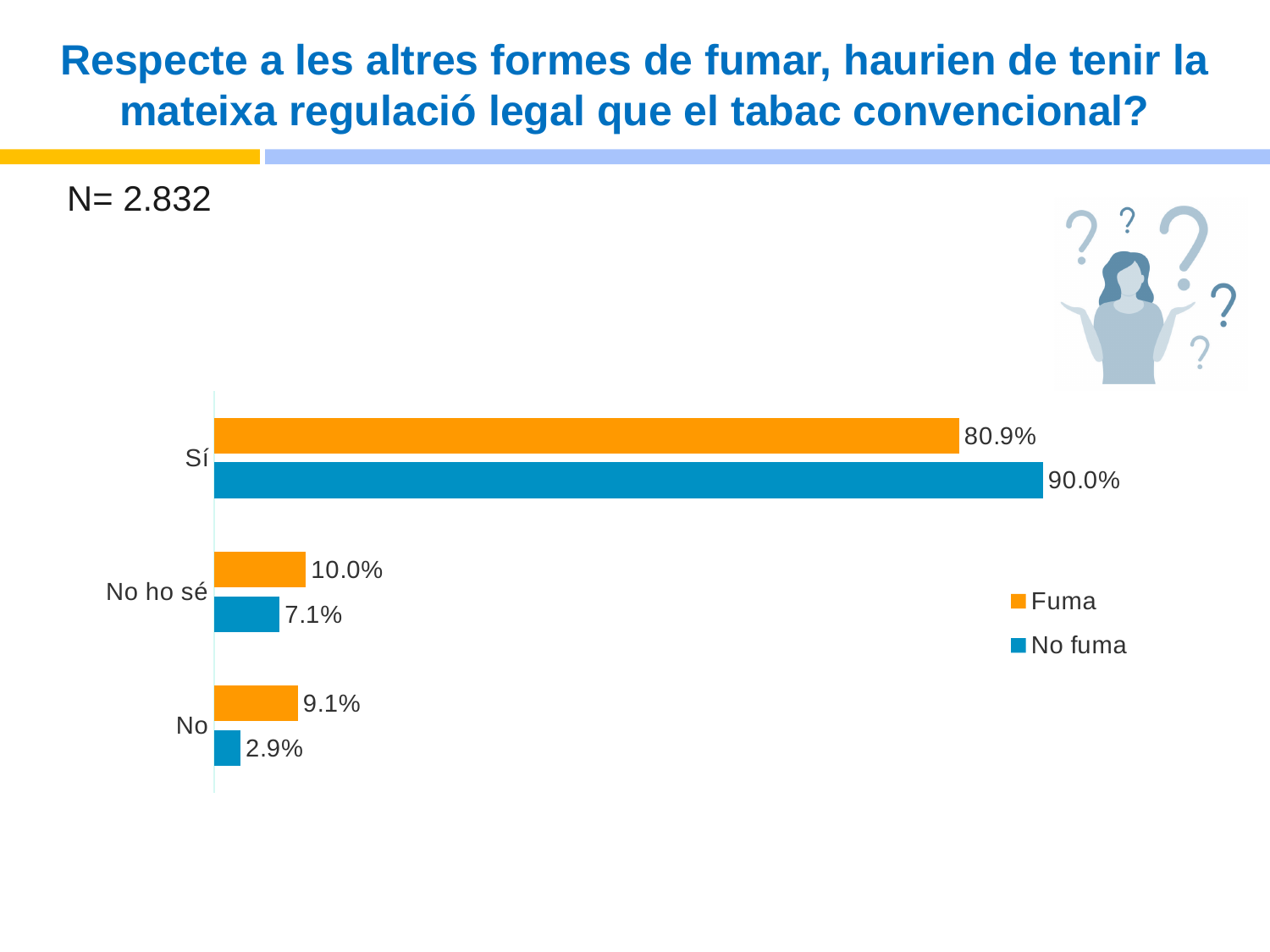
What kind of chart is shown on the slide? Bar chart What is the value for "No fuma" in the "Sí" category? 90.0% What is the difference between the "Fuma" and "No fuma" values in the "No" category? 6.2% What is the value for "Fuma" in the "Sí" category? 80.9% In the "No ho sé" category, which series has the larger value, "Fuma" or "No fuma"? Fuma What is the difference between the "No fuma" and "Fuma" values in the "Sí" category? 9.1% What is the value for "No fuma" in the "No" category? 2.9% How many series does the legend list? 2 What is the value for "Fuma" in the "No ho sé" category? 10.0% Which category has the highest value for the "No fuma" series? Sí Which category has the lowest value for the "Fuma" series? No How many categories are shown on the chart? 3